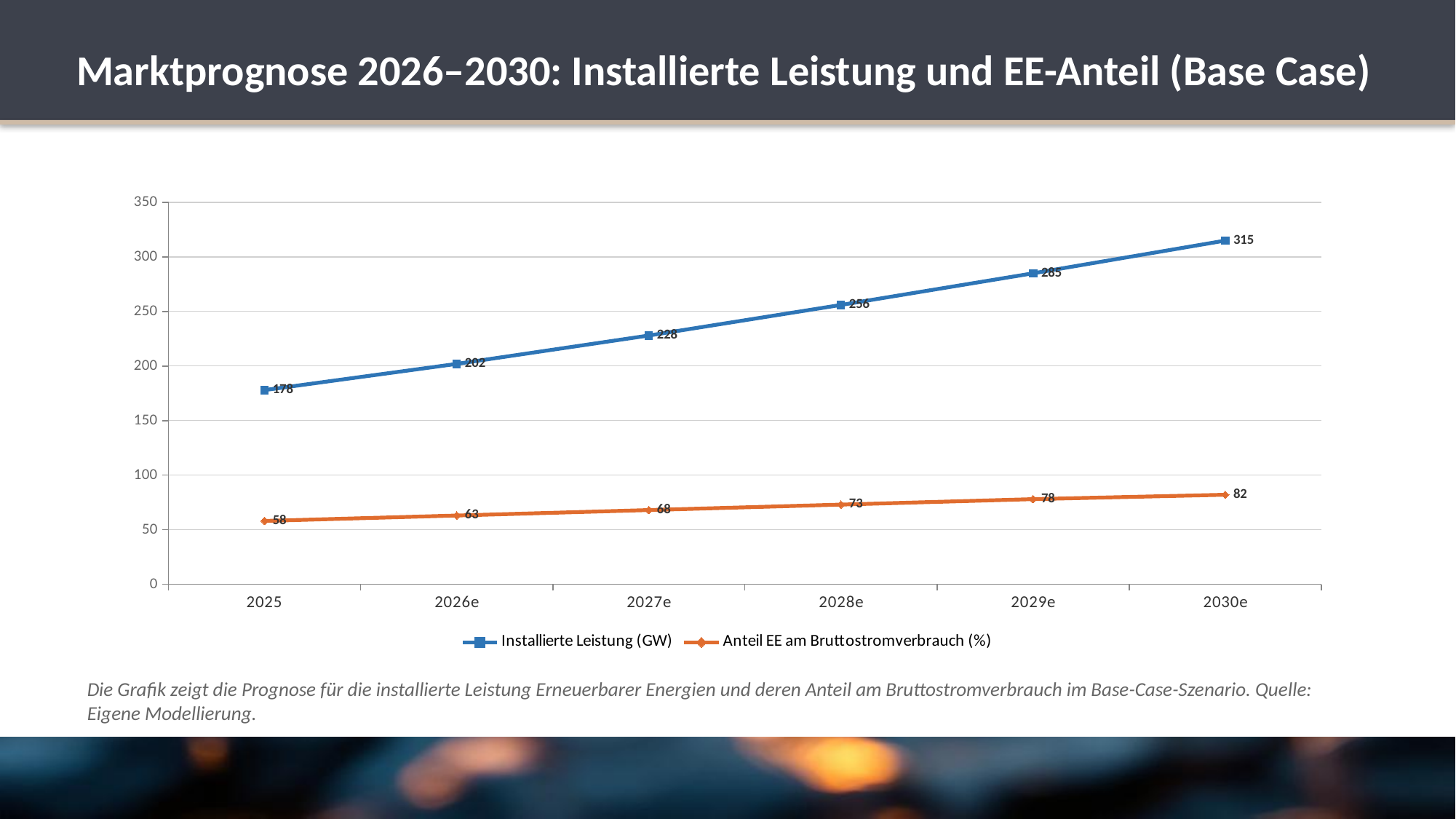
What is the difference between Installierte Leistung (GW) in 2030e and in 2025? 137 How many series does the legend list? 2 Is the value of Installierte Leistung (GW) for 2026e greater or less than 250? less What kind of chart is shown on the slide? line chart What is the value of Installierte Leistung (GW) for 2027e? 228 What is the value of Anteil EE am Bruttostromverbrauch (%) for 2029e? 78 Which is larger: Installierte Leistung (GW) in 2028e or in 2029e? 2029e In which year does Installierte Leistung (GW) reach its highest value? 2030e What is the value of Installierte Leistung (GW) for 2025? 178 What is the difference between Anteil EE am Bruttostromverbrauch (%) in 2028e and in 2026e? 10 In which year is Anteil EE am Bruttostromverbrauch (%) lowest? 2025 How many years are shown on the x axis? 6